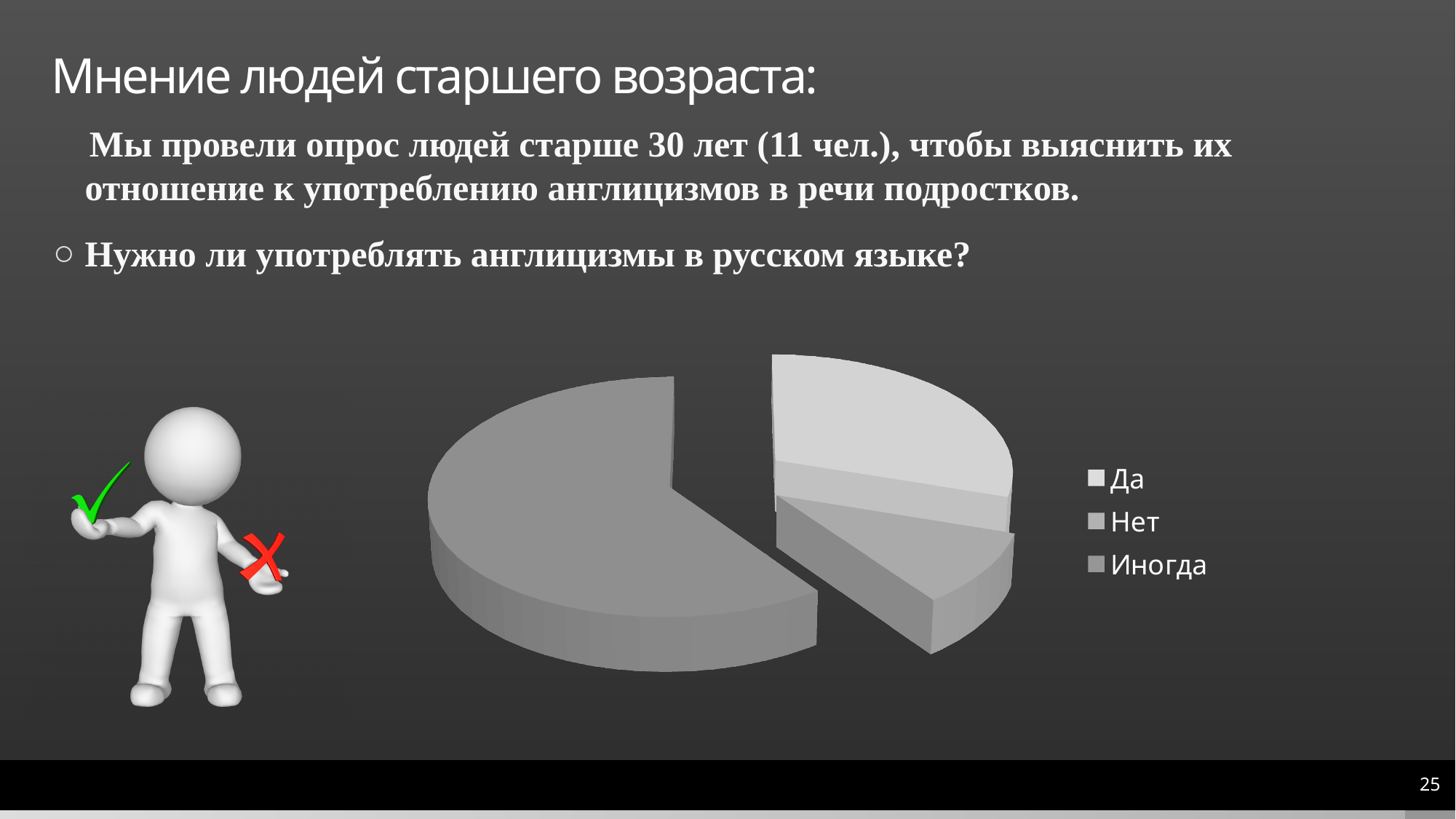
Which category has the largest slice in the pie chart? Иногда Which legend entry is shown with the lightest shade in the pie chart? Да What are the legend entries of the pie chart, in order from top to bottom? Да, Нет, Иногда Which category has the smallest slice in the pie chart? Нет What kind of chart is shown on the slide? pie chart Which slice is larger in the pie chart, Да or Нет? Да How many slices does the pie chart have? 3 Which slice is larger in the pie chart, Иногда or Да? Иногда How many entries does the legend of the pie chart list? 3